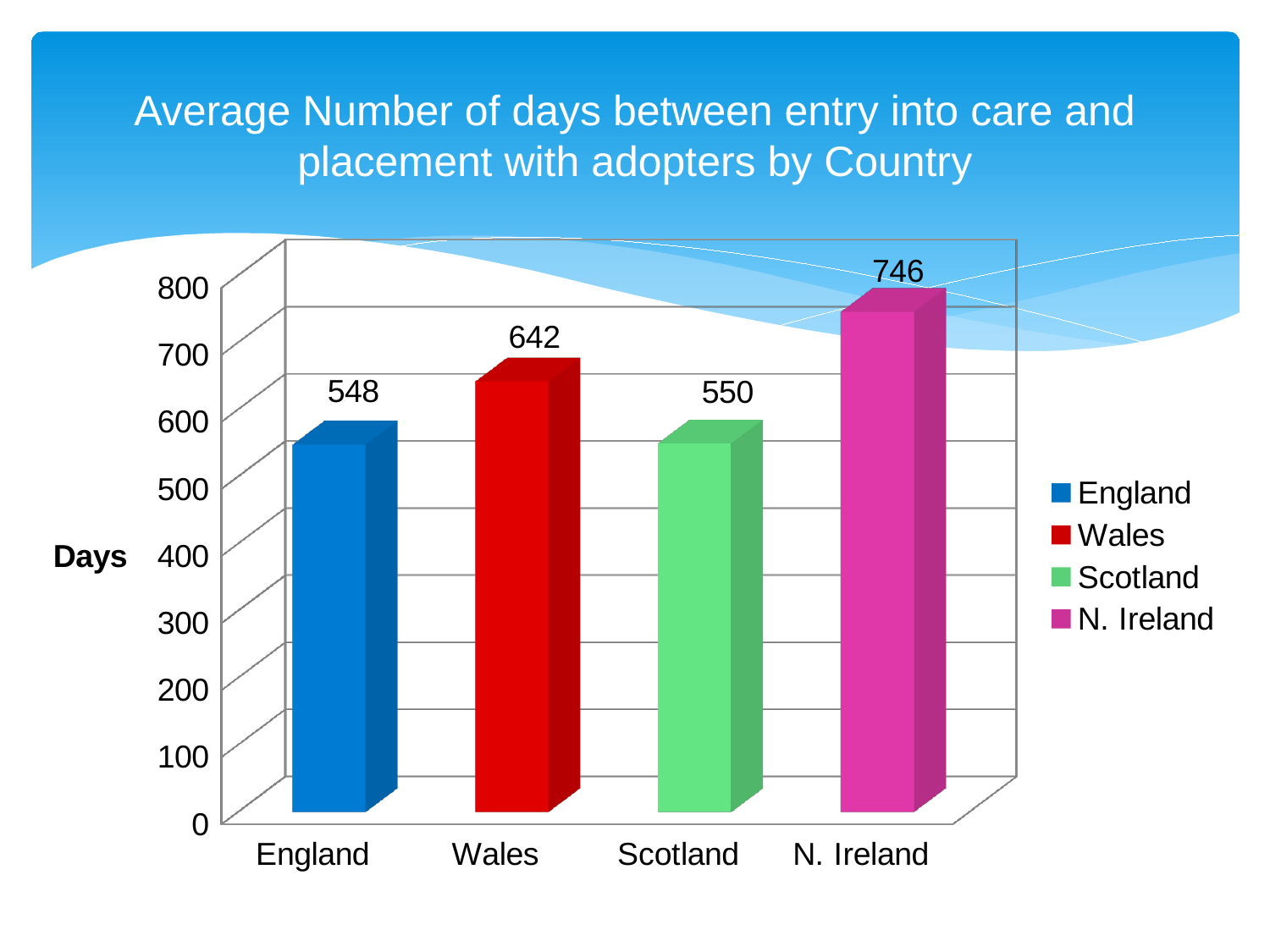
What is the label on the vertical axis of the chart? Days What kind of chart is shown on the slide? Bar chart What is the average number of days for Scotland? 550 Which has a larger value, Wales or Scotland? Wales What is the difference in days between Wales and Scotland? 92 How many countries are shown on the chart? 4 Which country has the lowest average number of days? England What is the average number of days for N. Ireland? 746 What is the average number of days for Wales? 642 What is the difference in days between N. Ireland and England? 198 Which country has the highest average number of days? N. Ireland What is the average number of days for England? 548